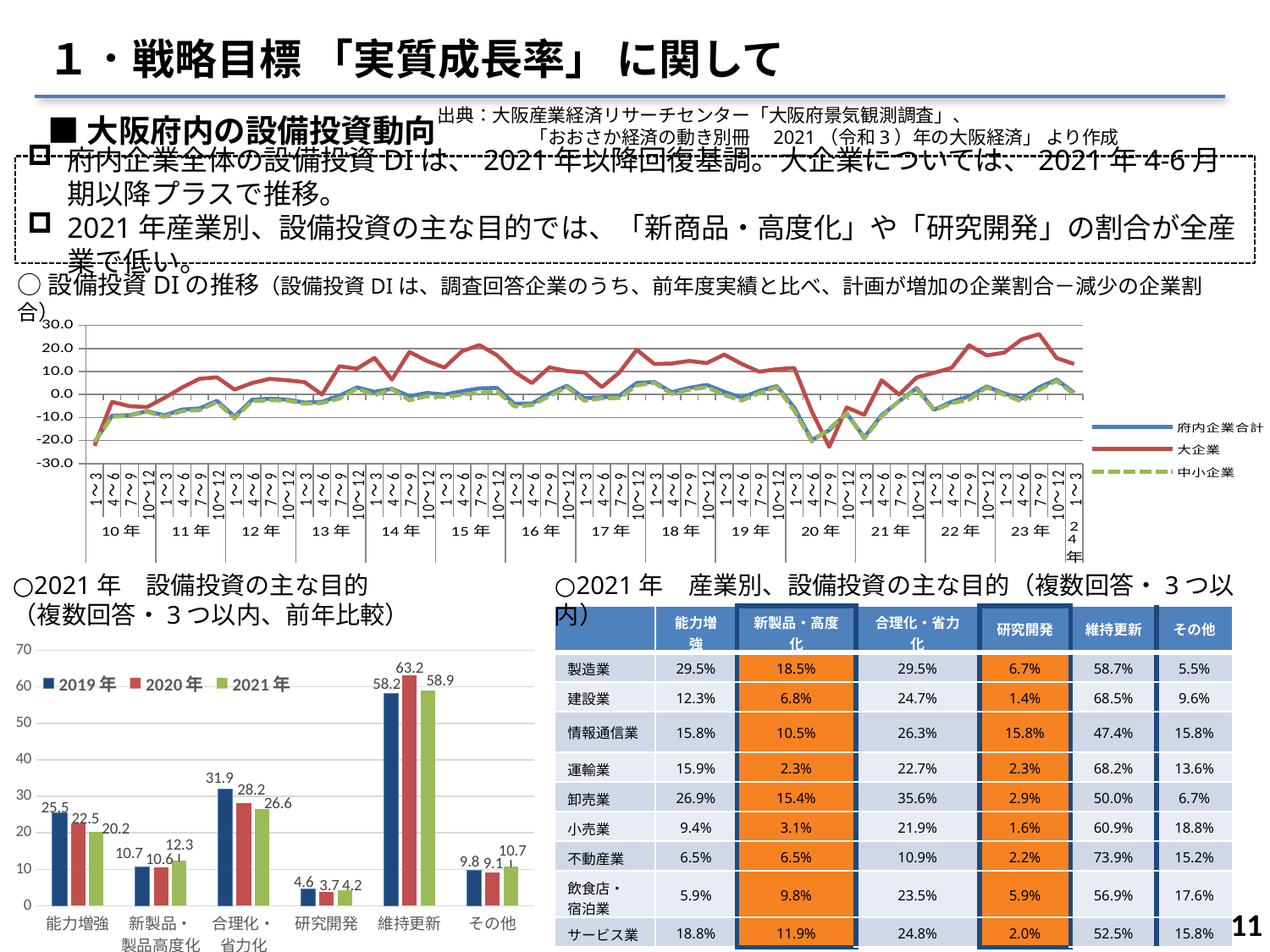
How many categories are shown on the x axis of the bar chart titled 2021年 設備投資の主な目的? 6 What kind of chart is the chart titled 設備投資DIの推移? line chart In the bar chart titled 2021年 設備投資の主な目的, what is the value for 能力増強 in the 2019年 series? 25.5 How many series does the legend of the line chart titled 設備投資DIの推移 list? 3 In the bar chart titled 2021年 設備投資の主な目的, what is the value for 維持更新 in the 2020年 series? 63.2 In the bar chart titled 2021年 設備投資の主な目的, which is larger for 新製品・製品高度化: the 2019年 value or the 2021年 value? 2021年 How many series does the legend of the bar chart titled 2021年 設備投資の主な目的 list? 3 In the bar chart titled 2021年 設備投資の主な目的, what is the difference between the 2019年 and 2021年 values for 合理化・省力化? 5.3 In the line chart titled 設備投資DIの推移, is the value for 大企業 at 23年 7~9 greater or less than 20.0? greater In the bar chart titled 2021年 設備投資の主な目的, which category has the highest value in the 2021年 series? 維持更新 In the bar chart titled 2021年 設備投資の主な目的, what is the value for 研究開発 in the 2021年 series? 4.2 In the bar chart titled 2021年 設備投資の主な目的, which category has the lowest value in the 2020年 series? 研究開発